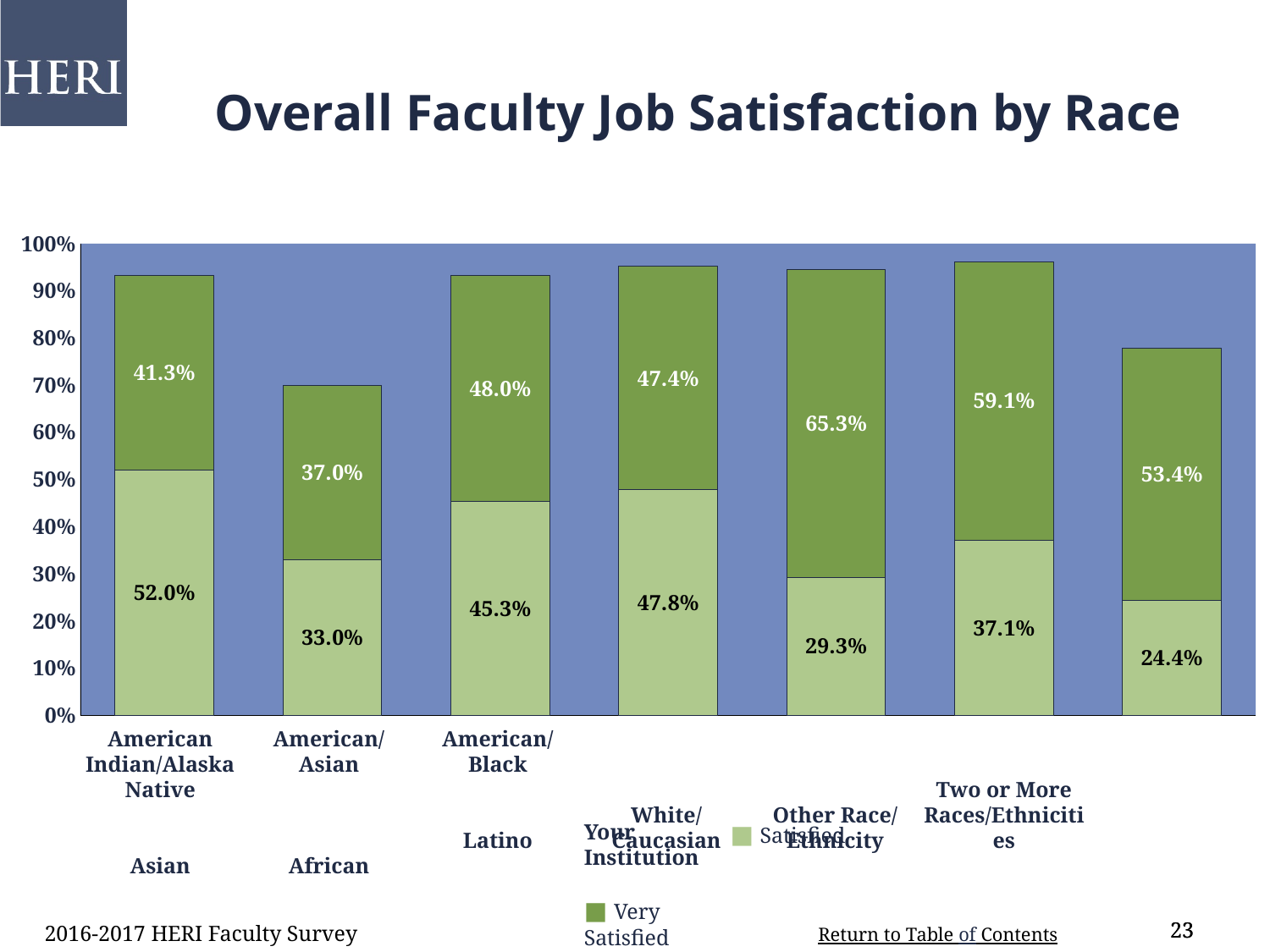
What is the Very Satisfied percentage for the rightmost bar? 53.4% What is the title of the chart? Overall Faculty Job Satisfaction by Race For the rightmost bar, what is the difference between the Very Satisfied and Satisfied percentages? 29.0% What is the combined Satisfied plus Very Satisfied total for the American Indian/Alaska Native bar? 93.3% What is the Satisfied percentage for American Indian/Alaska Native faculty? 52.0% What type of chart is shown on the slide? bar chart How many bars (race/ethnicity groups) are plotted in the chart? 7 For the second bar from the left, which is larger: the Satisfied value or the Very Satisfied value? Very Satisfied How many series does the legend list? 2 What is the largest Very Satisfied value shown in the chart? 65.3% What is the Very Satisfied percentage for American Indian/Alaska Native faculty? 41.3% What is the smallest Satisfied value shown in the chart? 24.4%